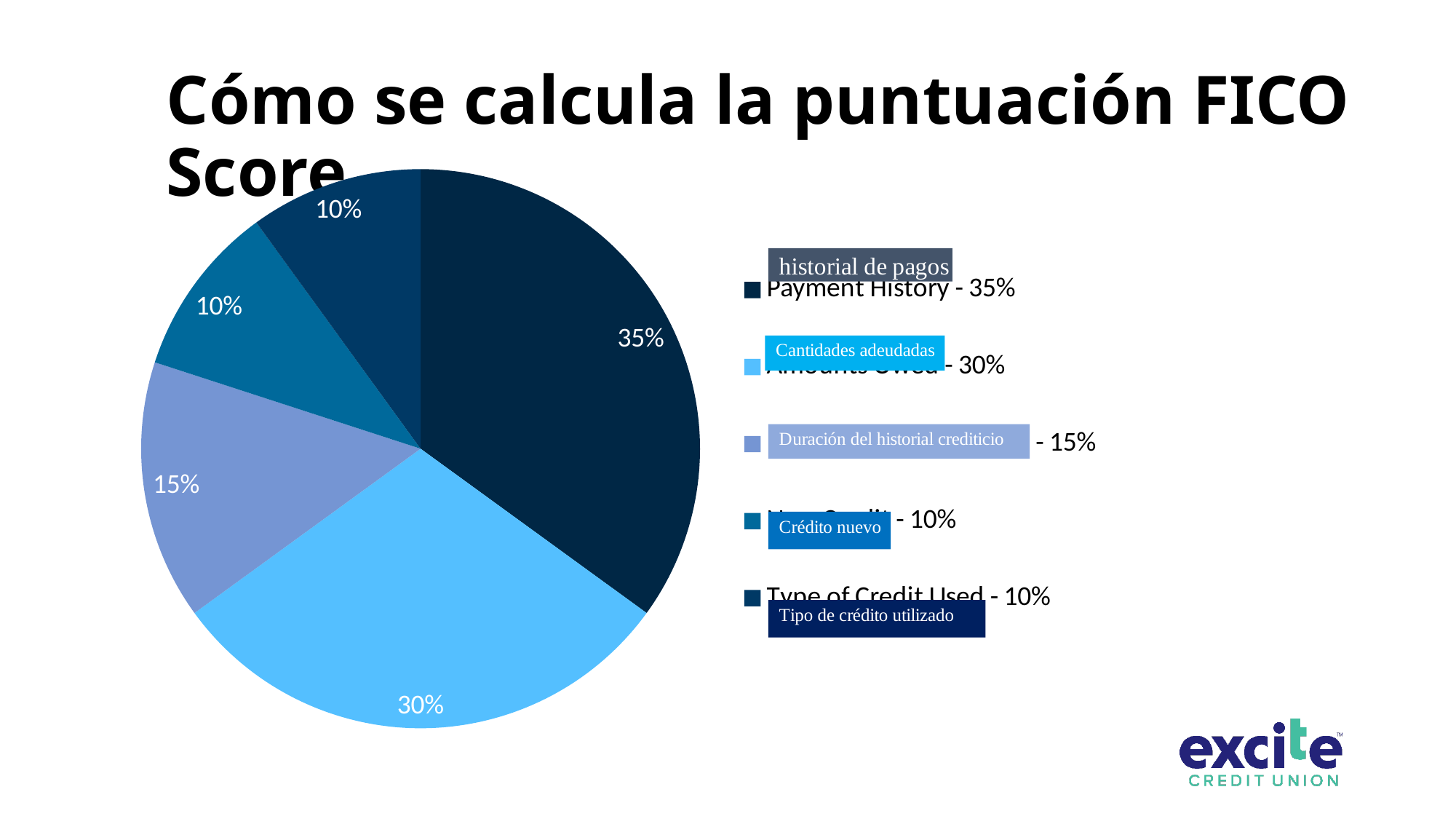
How many slices does the pie chart have? 5 What percentage is shown for 'Duración del historial crediticio'? 15% What percentage of the FICO score does 'historial de pagos' (Payment History) account for? 35% Which is larger: 'Cantidades adeudadas' or 'Duración del historial crediticio'? Cantidades adeudadas What is the difference in percentage points between 'historial de pagos' and 'Cantidades adeudadas'? 5 percentage points What share of the pie is 'Cantidades adeudadas'? 30% What kind of chart is shown on the slide? Pie chart What is the combined share of 'Crédito nuevo' and 'Tipo de crédito utilizado'? 20% What percentage is shown for 'Tipo de crédito utilizado' (Type of Credit Used)? 10% What percentage is shown for 'Crédito nuevo'? 10% What is the title of the slide? Cómo se calcula la puntuación FICO Score Which category has the largest slice of the pie? historial de pagos (Payment History)